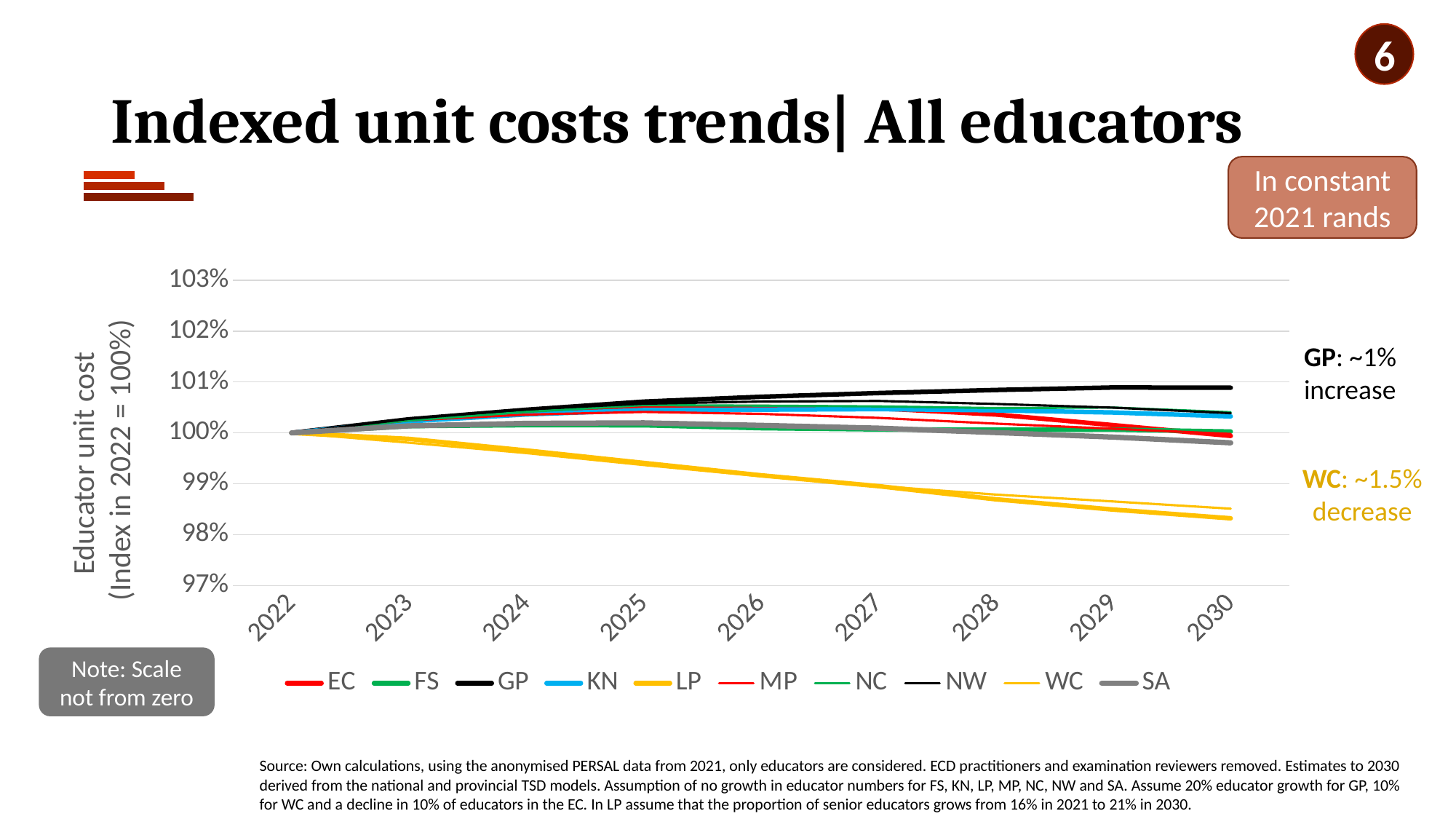
Does the GP line rise or fall from 2022 to 2030? rise Is the value for WC in 2030 greater or less than 99%? less Is the value for LP in 2030 greater or less than 99%? less Which is larger in 2030, the value for GP or the value for LP? GP How many years are shown along the x axis? 9 Does the LP line rise or fall from 2022 to 2030? fall What kind of chart is shown on the slide? line chart Is the value for GP in 2030 greater or less than 100%? greater What is the y-axis title of the chart? Educator unit cost (Index in 2022 = 100%) Which series has the highest value in 2030? GP What is the indexed unit cost value for every series in 2022? 100% How many series does the legend list? 10